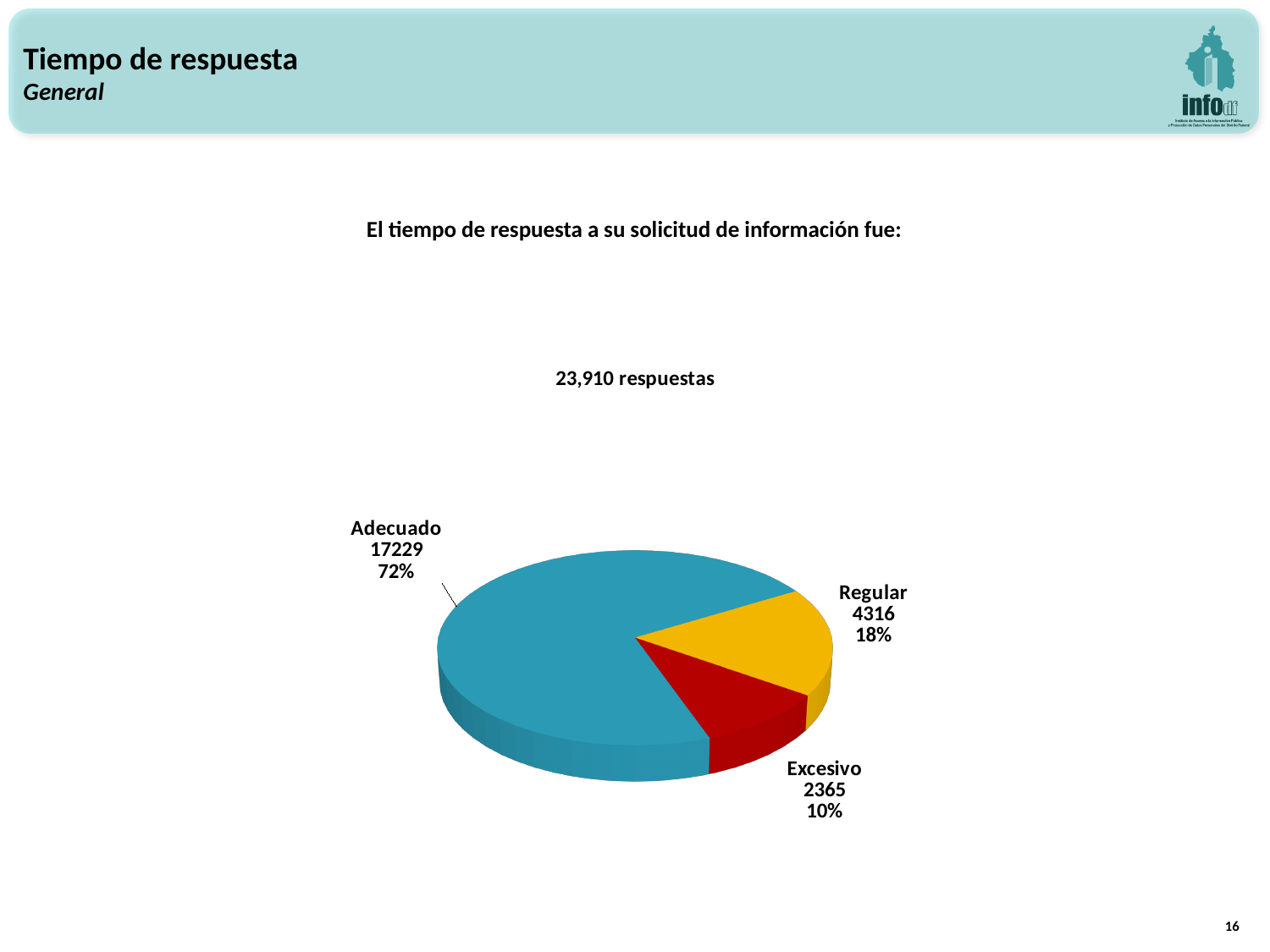
Which category has the largest slice? Adecuado What is the number of responses for Excesivo? 2365 Which has more responses, Regular or Excesivo? Regular What kind of chart is shown on the slide? pie chart What share of the pie does Adecuado represent? 72% What is the number of responses for Regular? 4316 How many slices does the pie chart have? 3 What colour is the Regular slice? yellow What is the number of responses for Adecuado? 17229 What is the difference in responses between Regular and Excesivo? 1951 Which category has the smallest slice? Excesivo What share of the pie does Excesivo represent? 10%